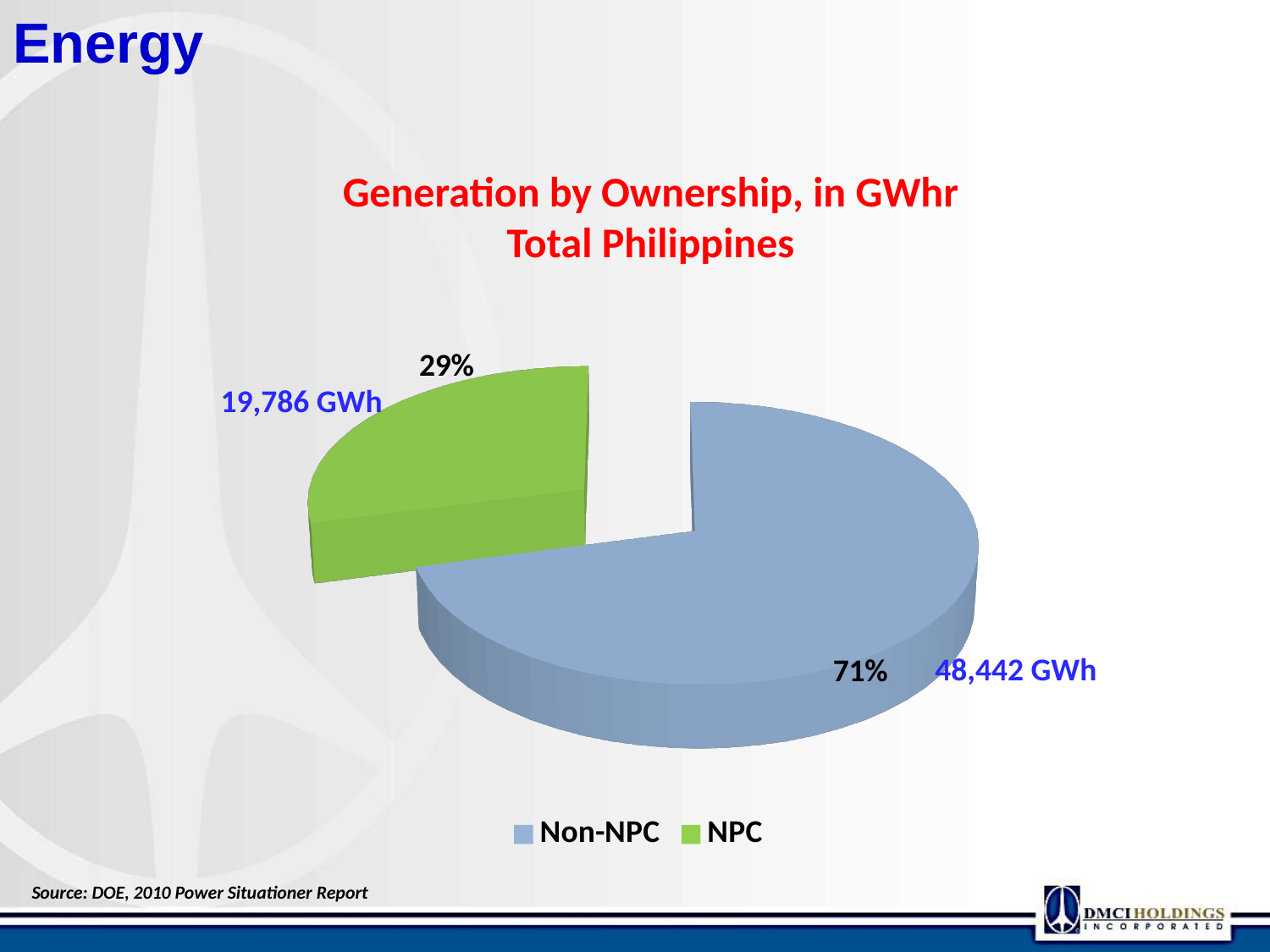
What share of the pie does the Non-NPC slice represent? 71% What is the title of the chart? Generation by Ownership, in GWhr Total Philippines Which ownership category has the smallest share of generation? NPC What is the generation value for NPC? 19,786 GWh What share of the pie does the NPC slice represent? 29% What is the total generation of the two slices combined, in GWh? 68,228 GWh What type of chart is shown on the slide? Pie chart How many slices does the pie chart have? 2 Which is larger, the generation for Non-NPC or for NPC? Non-NPC What is the difference in GWh between Non-NPC and NPC generation? 28,656 GWh Which ownership category has the largest share of generation? Non-NPC What is the generation value for Non-NPC? 48,442 GWh